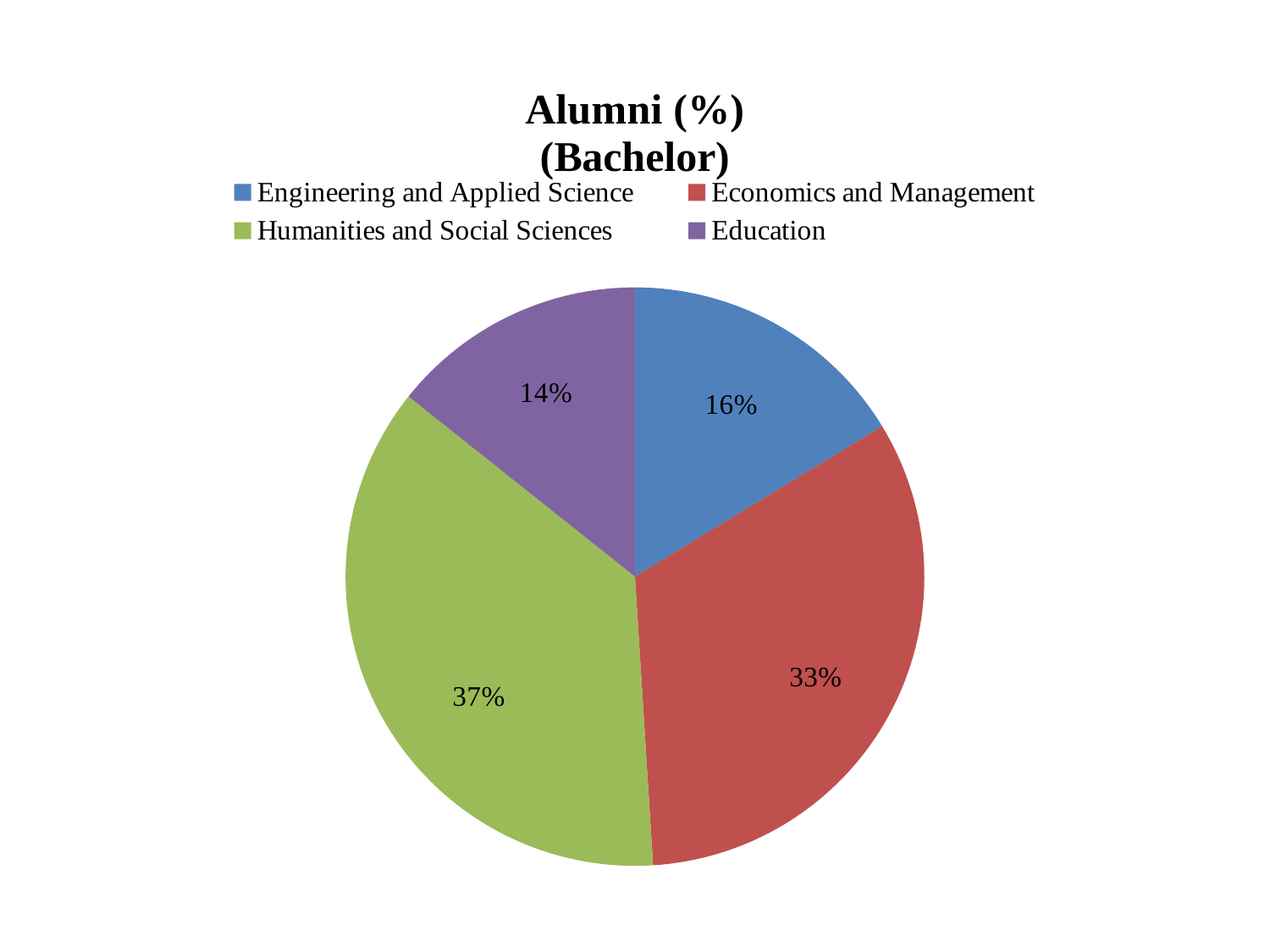
How many categories are shown in the pie chart? 4 What is the difference in percentage points between Humanities and Social Sciences and Economics and Management? 4 What type of chart is shown on the slide? pie chart Which category has the largest share of the pie? Humanities and Social Sciences Which is larger, the share for Engineering and Applied Science or the share for Education? Engineering and Applied Science What percentage of alumni is shown for Economics and Management? 33% Which category has the smallest share of the pie? Education What is the title of the chart? Alumni (%) (Bachelor) What colour is the slice for Economics and Management? red What percentage of alumni is shown for Humanities and Social Sciences? 37% What percentage of alumni is shown for Engineering and Applied Science? 16% What percentage of alumni is shown for Education? 14%